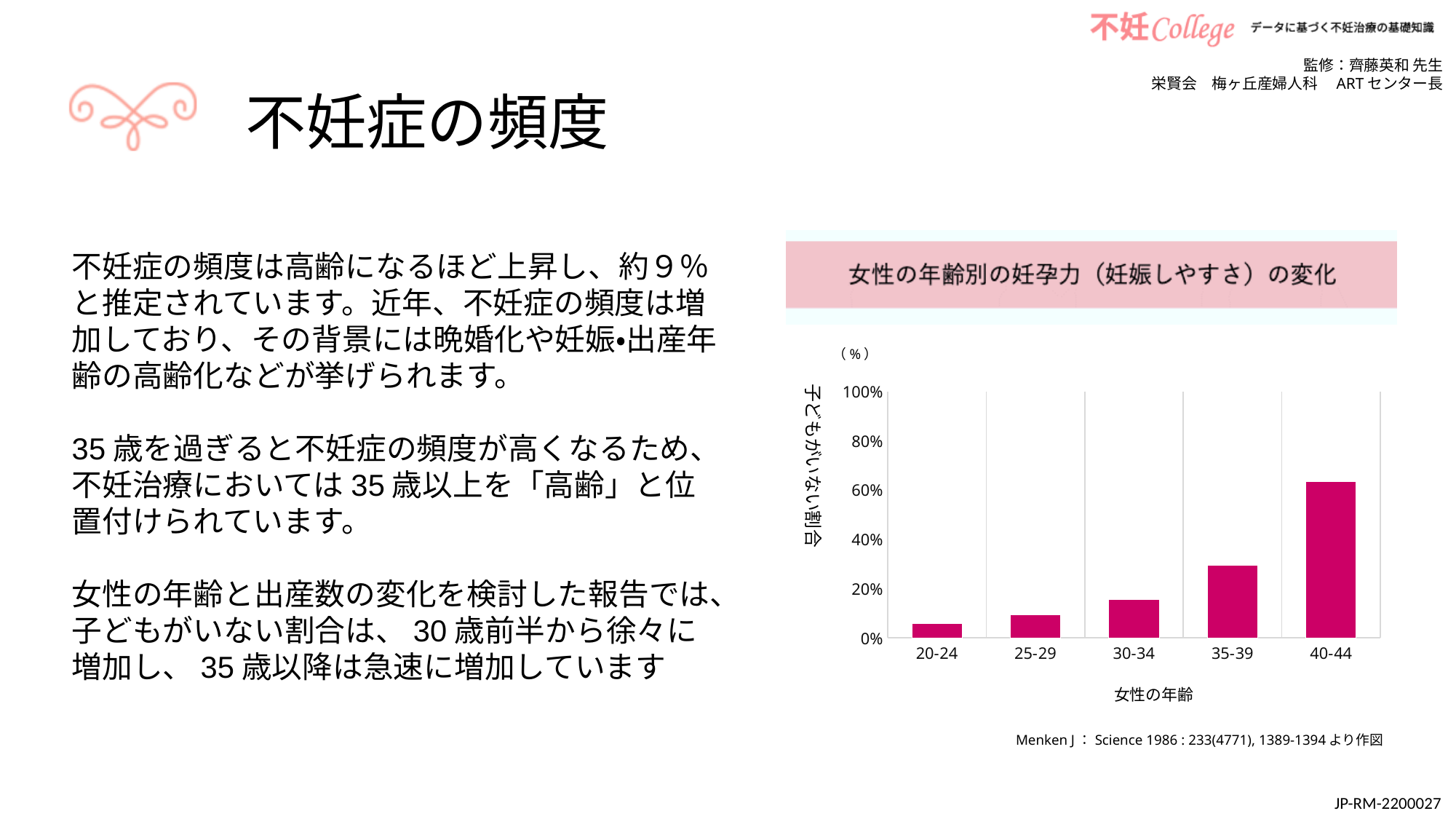
Is the value for the 35-39 age group greater or less than 40%? less What kind of chart is shown on the slide? Bar chart Is the value for the 30-34 age group greater or less than 20%? less Which has a larger value, the 35-39 age group or the 30-34 age group? 35-39 Which age group has the lowest value in the chart? 20-24 Is the value for the 40-44 age group greater or less than 80%? less What is the title of the chart? 女性の年齢別の妊孕力（妊娠しやすさ）の変化 Do the values rise or fall as age increases along the x axis? Rise How many age groups are shown on the x axis of the chart? 5 What is the label of the x axis of the chart? 女性の年齢 Which age group has the highest value in the chart? 40-44